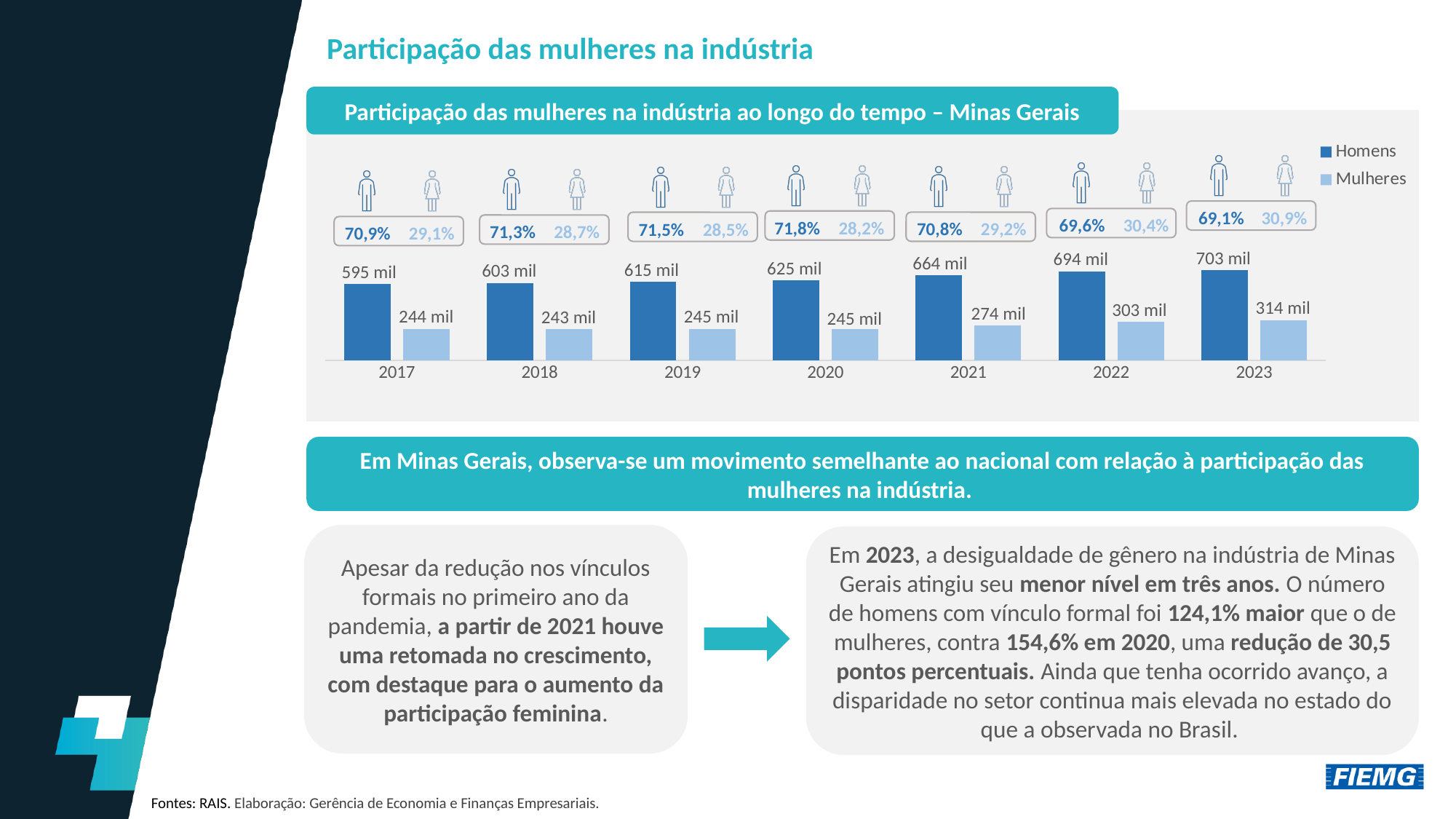
How many years are shown on the x axis? 7 How many series does the legend list? 2 In which year is the value for Homens lowest? 2017 Which year has the larger value for Mulheres, 2020 or 2021? 2021 What is the value for Mulheres in 2019? 245 mil What is the difference between Homens and Mulheres in 2023? 389 mil Do the values for Homens rise or fall from 2017 to 2023? rise What is the value for Homens in 2023? 703 mil In which year is the value for Mulheres highest? 2023 What kind of chart is shown on the slide? bar chart What percentage share is shown for Mulheres in 2022? 30,4% What are the two entries in the chart legend? Homens, Mulheres